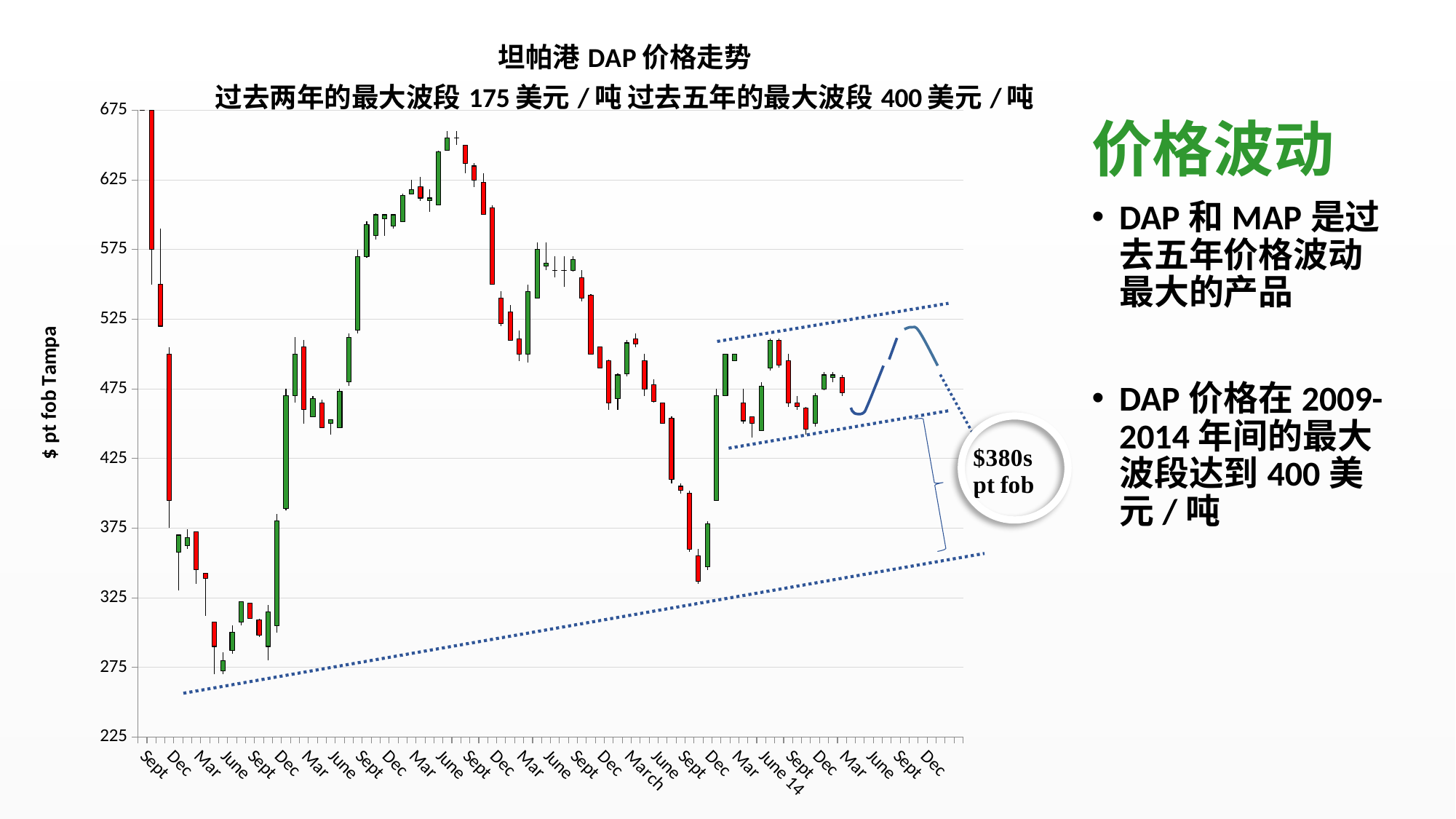
What is the lowest value shown on the vertical axis of the chart? 225 What is the label on the vertical axis of the chart? $ pt fob Tampa What price level is written in the circled annotation on the chart? $380s pt fob What is the title of the chart? 坦帕港 DAP 价格走势 What kind of chart is shown on the slide? Candlestick (stock) chart What is the highest value shown on the vertical axis of the chart? 675 Do prices rise or fall from the peak near June (around 650) to the Sept low two years later? fall Is the lowest price reached on the chart greater or less than 300? less Do prices rise or fall from the first Sept on the x axis to the following Mar? fall Is the price at the last candle on the chart (Mar) greater or less than 425? greater Is the highest price reached on the chart greater or less than 625? greater Is the price at the first candle (Sept) higher or lower than the price at the last candle (Mar)? higher